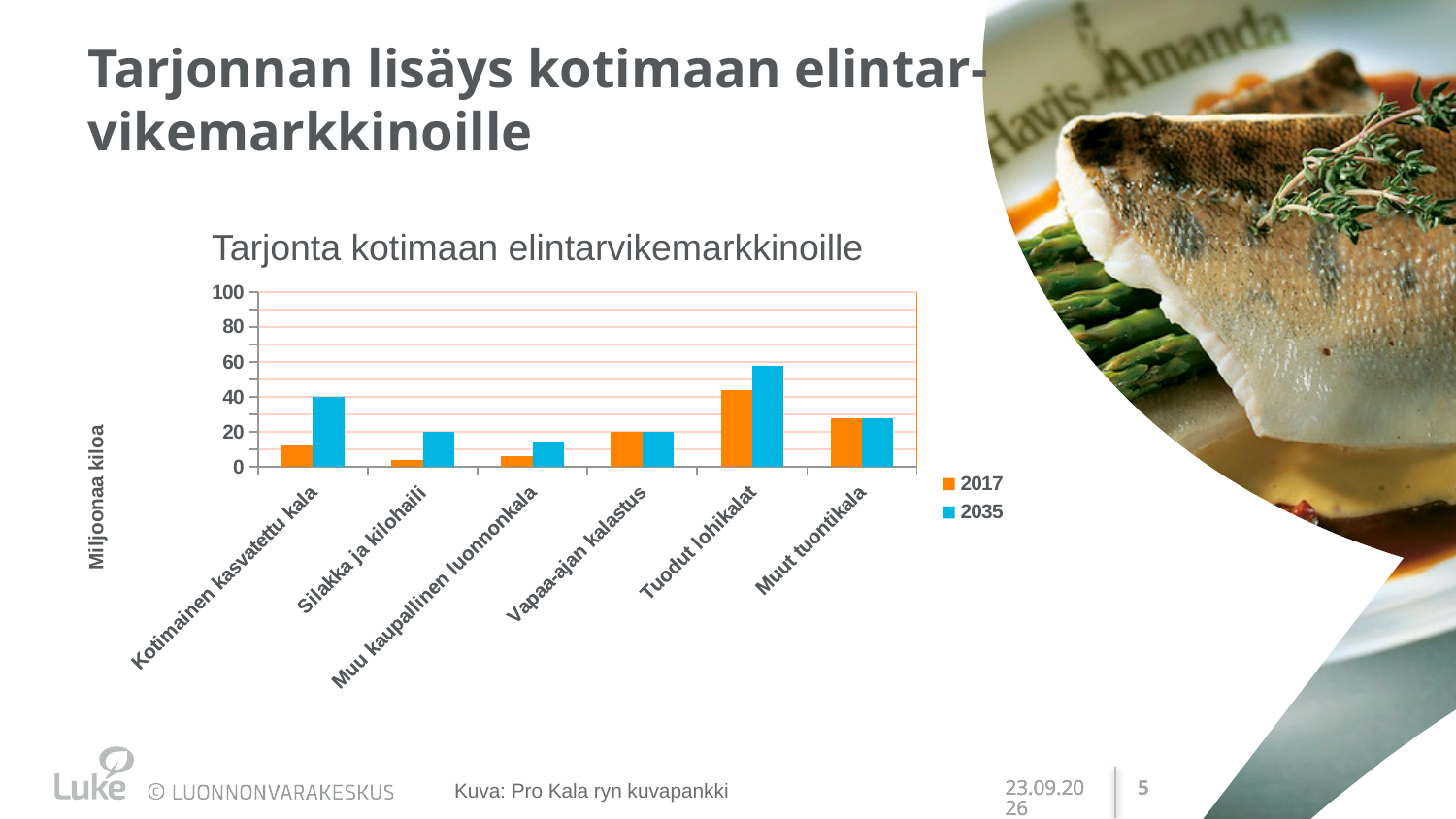
How many categories are shown on the x axis of the chart? 6 How many series does the chart legend list? 2 Which category has the highest value for the 2017 series? Tuodut lohikalat For Kotimainen kasvatettu kala, which series has the larger value, 2017 or 2035? 2035 What kind of chart is shown on the slide? bar chart What is the title of the chart? Tarjonta kotimaan elintarvikemarkkinoille What is the label on the vertical axis of the chart? Miljoonaa kiloa Is the 2035 value for Tuodut lohikalat greater or less than 40? greater Is the 2017 value for Muut tuontikala greater or less than 20? greater Which category has the lowest value for the 2017 series? Silakka ja kilohaili Is the 2017 value for Kotimainen kasvatettu kala greater or less than 20? less Which category has the highest value for the 2035 series? Tuodut lohikalat